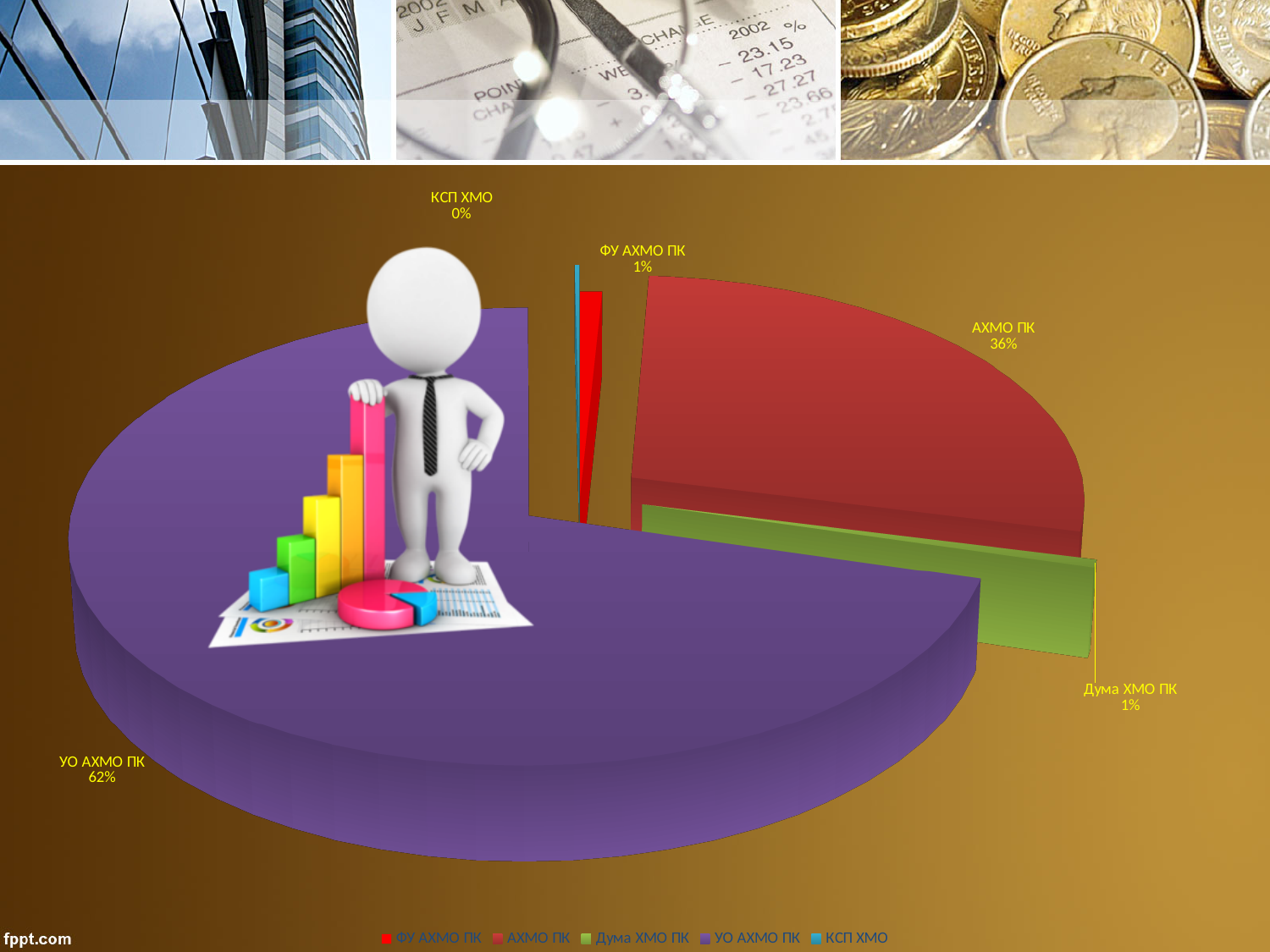
What share of the pie does УО АХМО ПК hold? 62% What value is labelled for КСП ХМО? 0% What colour is the slice for УО АХМО ПК? Purple What percentage is shown for АХМО ПК? 36% What is the combined share of ФУ АХМО ПК and Дума ХМО ПК? 2% Which category has the largest slice of the pie? УО АХМО ПК Which is larger, the share for АХМО ПК or the share for ФУ АХМО ПК? АХМО ПК How many categories are shown in the pie chart? 5 What percentage is shown for Дума ХМО ПК? 1% By how many percentage points does УО АХМО ПК exceed АХМО ПК? 26 Which category has the smallest share of the pie? КСП ХМО What type of chart is shown on the slide? Pie chart